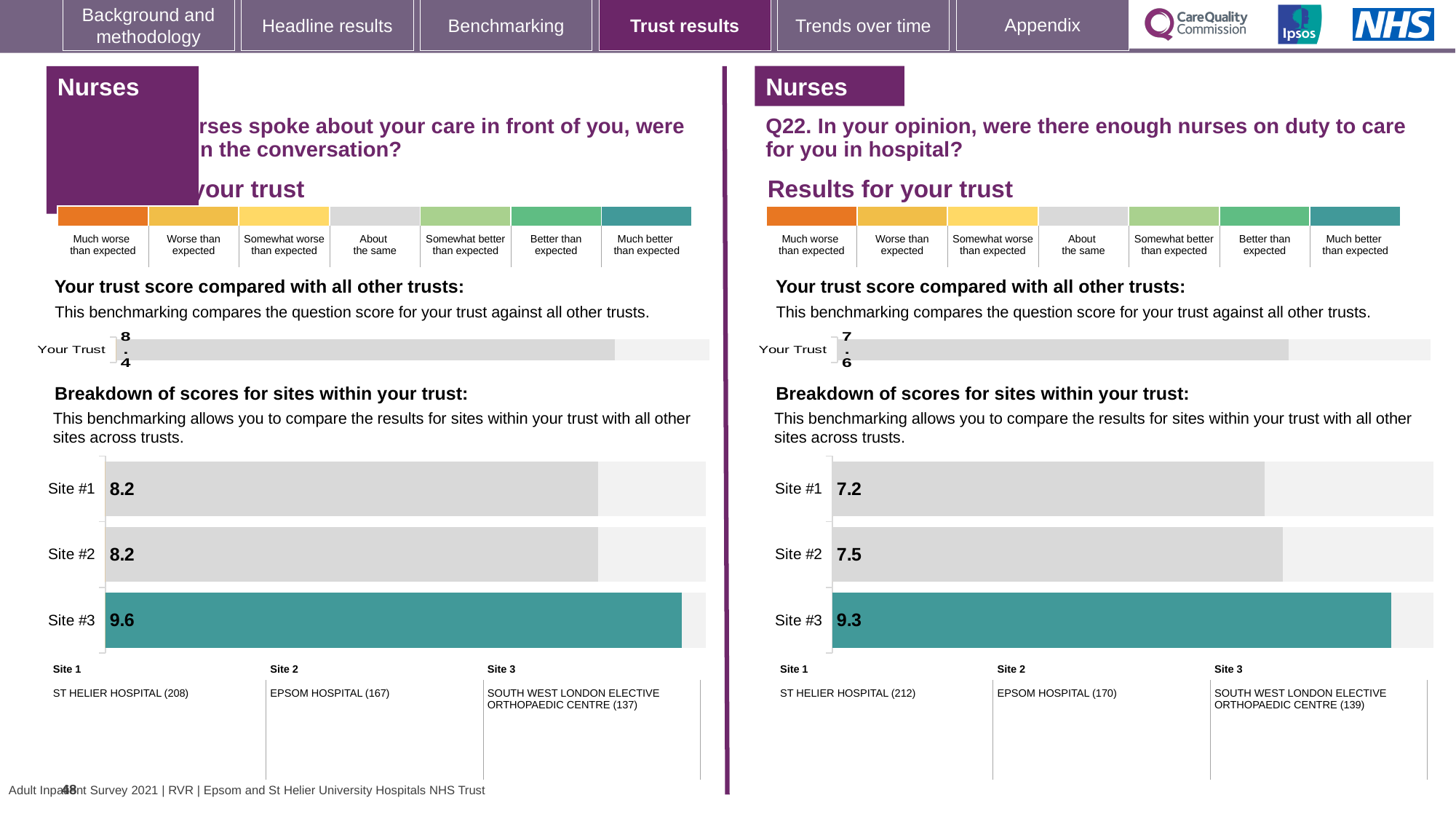
On the left-hand site breakdown chart, what is the difference between the scores for Site #3 and Site #1? 1.4 On the right-hand (Q22) site breakdown chart, what is the score for Site #3? 9.3 On the right-hand (Q22) site breakdown chart, what is the difference between the scores for Site #3 and Site #1? 2.1 What type of chart is used for the site breakdown on the right-hand (Q22) side? Bar chart On the left-hand site breakdown chart, what is the score for Site #2? 8.2 How many sites are shown on the left-hand site breakdown chart? 3 On the right-hand (Q22) site breakdown chart, which site has the highest score? Site #3 On the right-hand (Q22) site breakdown chart, which is larger, the score for Site #2 or Site #1? Site #2 On the right-hand (Q22) 'Your trust score compared with all other trusts' chart, what is the score for Your Trust? 7.6 On the right-hand (Q22) site breakdown chart, what is the score for Site #1? 7.2 On the left-hand site breakdown chart, what is the score for Site #3? 9.6 On the right-hand (Q22) site breakdown chart, which site has the lowest score? Site #1